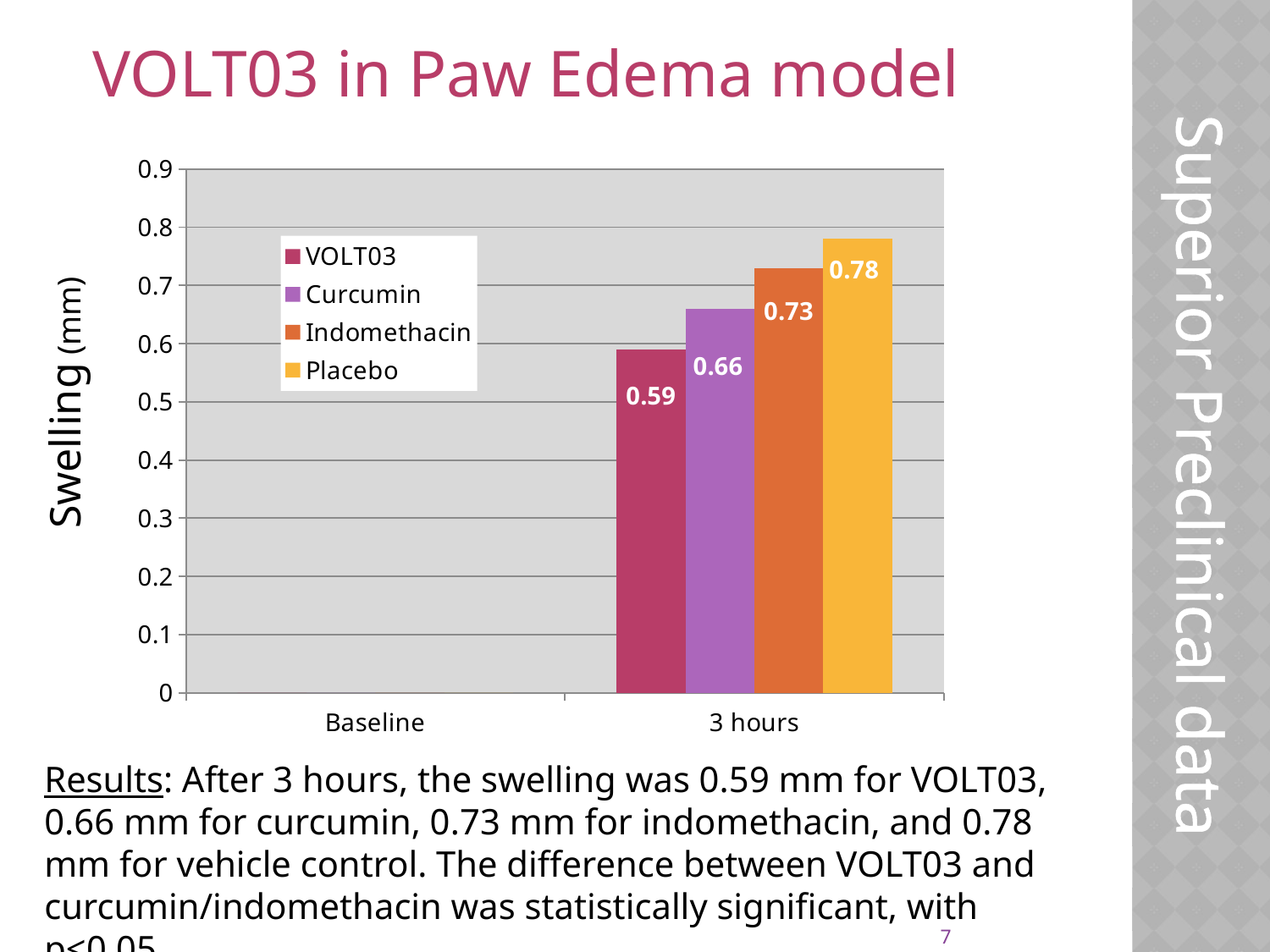
At 3 hours, which has a larger swelling value, Curcumin or Indomethacin? Indomethacin What is the swelling value for Curcumin at 3 hours? 0.66 What is the difference between the Placebo and VOLT03 swelling values at 3 hours? 0.19 What is the swelling value for Placebo at 3 hours? 0.78 Which series has the highest swelling at 3 hours? Placebo What is the swelling value for VOLT03 at 3 hours? 0.59 What is the swelling value for Indomethacin at 3 hours? 0.73 What is the difference between the Indomethacin and Curcumin swelling values at 3 hours? 0.07 Which series has the lowest swelling at 3 hours? VOLT03 What is the label of the y axis? Swelling (mm) How many series does the legend list? 4 What kind of chart is shown on the slide? Bar chart